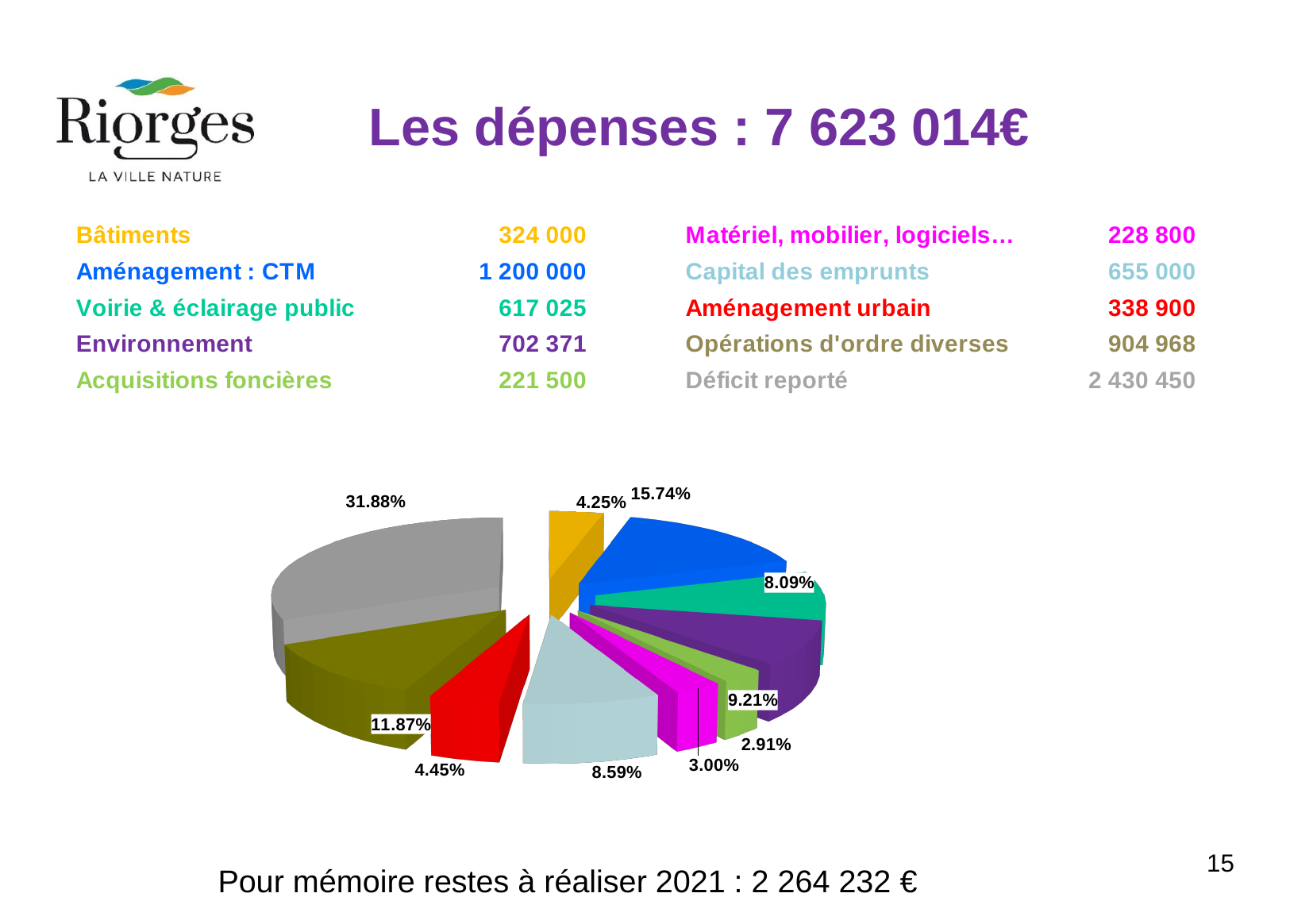
What total amount of expenses is given in the slide title? 7 623 014€ What is the smallest percentage shown on the pie chart? 2.91% Which is larger, the value for Capital des emprunts or the value for Voirie & éclairage public? Capital des emprunts How many slices does the pie chart have? 10 What is the value listed for Environnement? 702 371 What share of the pie does the blue slice (Aménagement : CTM) represent? 15.74% What share of the pie does the grey slice (Déficit reporté) represent? 31.88% What is the value listed for Déficit reporté? 2 430 450 What is the difference between the value for Aménagement : CTM and the value for Bâtiments? 876 000 What is the largest percentage shown on the pie chart? 31.88% What share of the pie does the olive slice (Opérations d'ordre diverses) represent? 11.87% What kind of chart is shown on the slide? pie chart